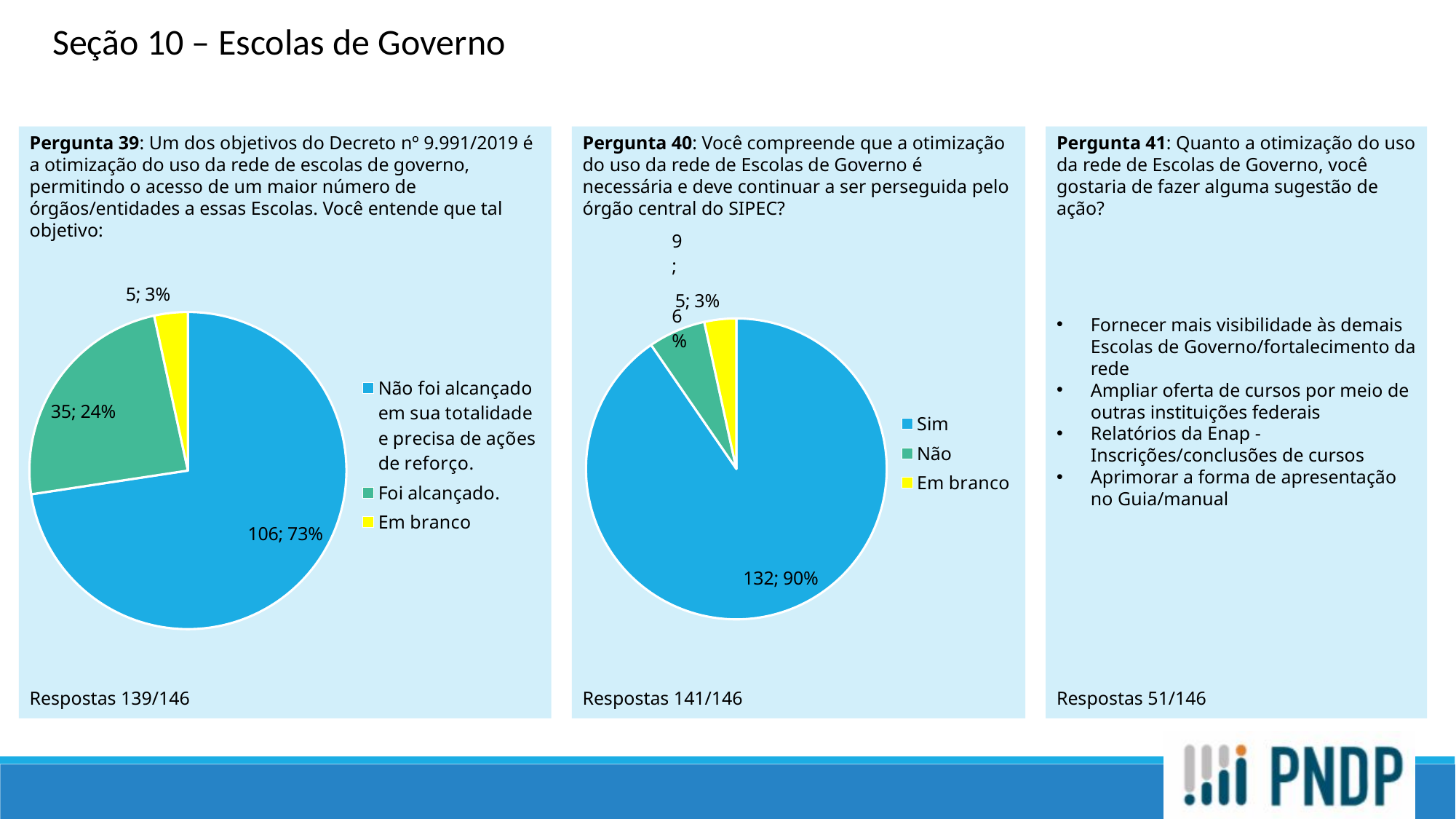
In the Pergunta 39 pie chart, which category has the smallest slice? Em branco In the Pergunta 39 pie chart, what is the difference in responses between 'Não foi alcançado em sua totalidade e precisa de ações de reforço.' and 'Foi alcançado.'? 71 In the Pergunta 39 pie chart, how many responses were 'Foi alcançado.'? 35 In the Pergunta 40 pie chart, what is the difference in responses between 'Sim' and 'Não'? 123 In the Pergunta 40 pie chart, how many responses were 'Sim'? 132 What type of chart is used for Pergunta 40? Pie chart In the Pergunta 40 pie chart, which has more responses, 'Não' or 'Em branco'? Não In the Pergunta 39 pie chart, what colour is the 'Em branco' slice? Yellow In the Pergunta 40 pie chart, which category has the largest slice? Sim In the Pergunta 39 pie chart, what percentage share does 'Não foi alcançado em sua totalidade e precisa de ações de reforço.' have? 73% How many categories does the Pergunta 39 pie chart show? 3 In the Pergunta 40 pie chart, what percentage share does 'Sim' have? 90%